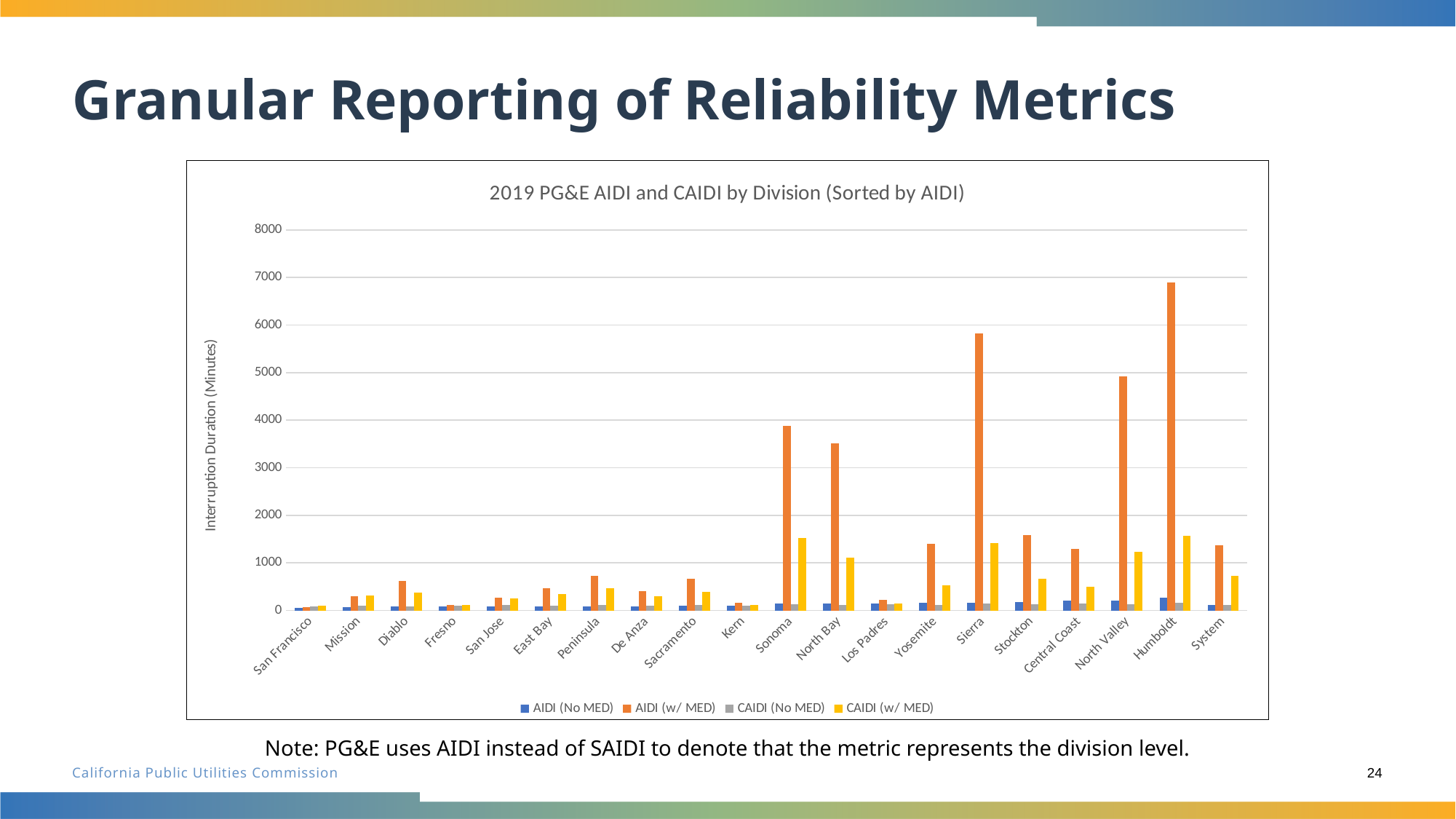
Is the AIDI (w/ MED) value for Sonoma greater or less than 3000? greater Which is larger, the AIDI (w/ MED) value for Sierra or for North Valley? Sierra What is the title of the chart? 2019 PG&E AIDI and CAIDI by Division (Sorted by AIDI) Is the AIDI (w/ MED) value for Sierra greater or less than 5000? greater What is the label on the vertical axis of the chart? Interruption Duration (Minutes) How many series does the chart's legend list? 4 Is the AIDI (w/ MED) value for North Valley greater or less than 4000? greater What kind of chart is shown on the slide? bar chart Which division has the highest AIDI (w/ MED) value? Humboldt How many divisions (categories) are shown along the x axis of the chart? 20 Which is larger, the AIDI (w/ MED) value for Sonoma or for North Bay? Sonoma